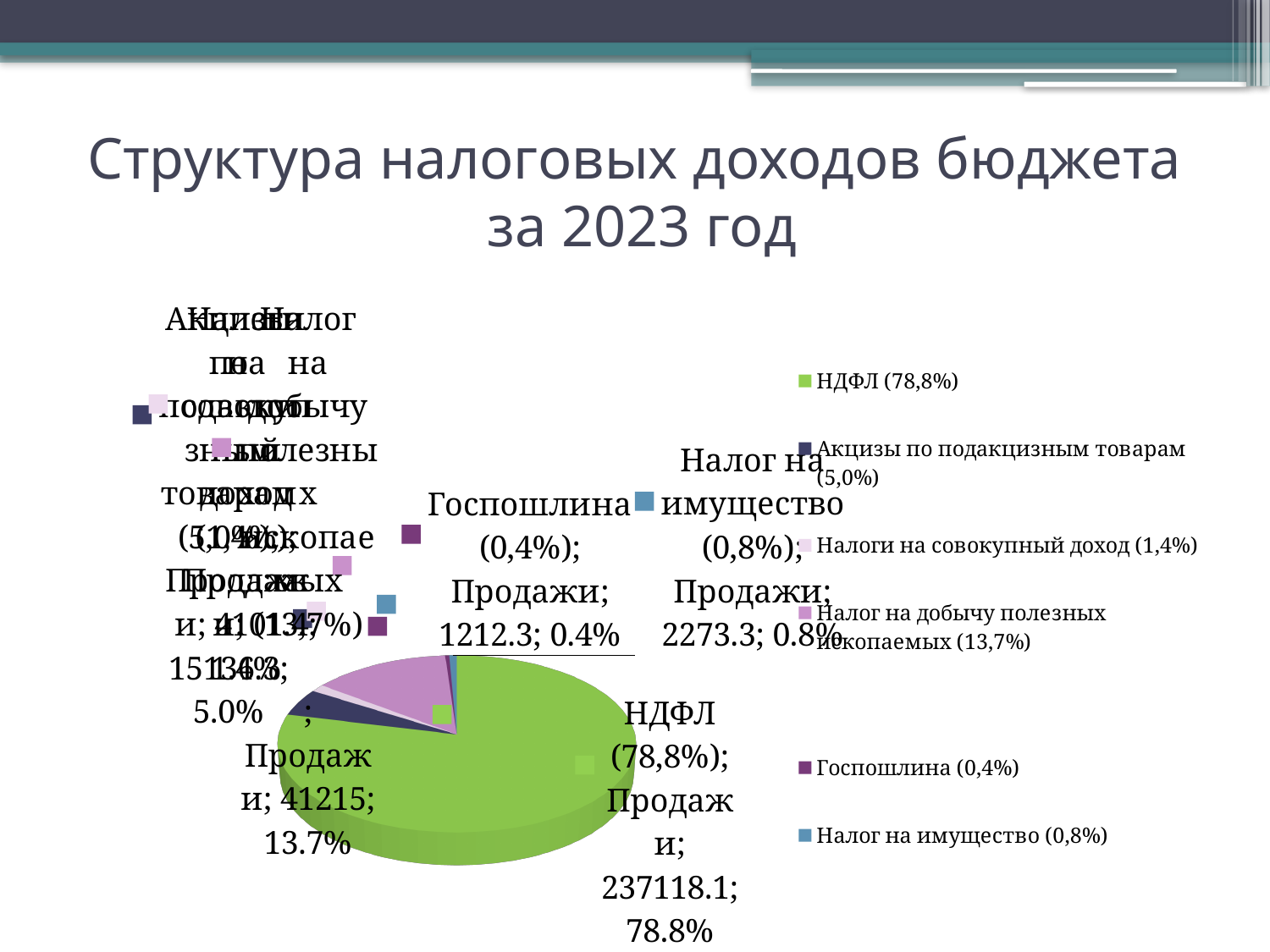
What is the value shown for Налог на имущество? 2273.3 What is the value shown for НДФЛ? 237118.1 What share of the pie does Налог на добычу полезных ископаемых have, according to the legend? 13,7% What percentage share does НДФЛ have in the pie? 78.8% What is the value shown for Госпошлина? 1212.3 What is the title of the slide containing the chart? Структура налоговых доходов бюджета за 2023 год How many entries does the chart legend list? 6 What is the value shown for Налог на добычу полезных ископаемых? 41215 Which category has the largest slice of the pie? НДФЛ Which is larger, the value for Налог на имущество or the value for Госпошлина? Налог на имущество What kind of chart is shown on the slide? pie chart Which category has the smallest slice of the pie? Госпошлина